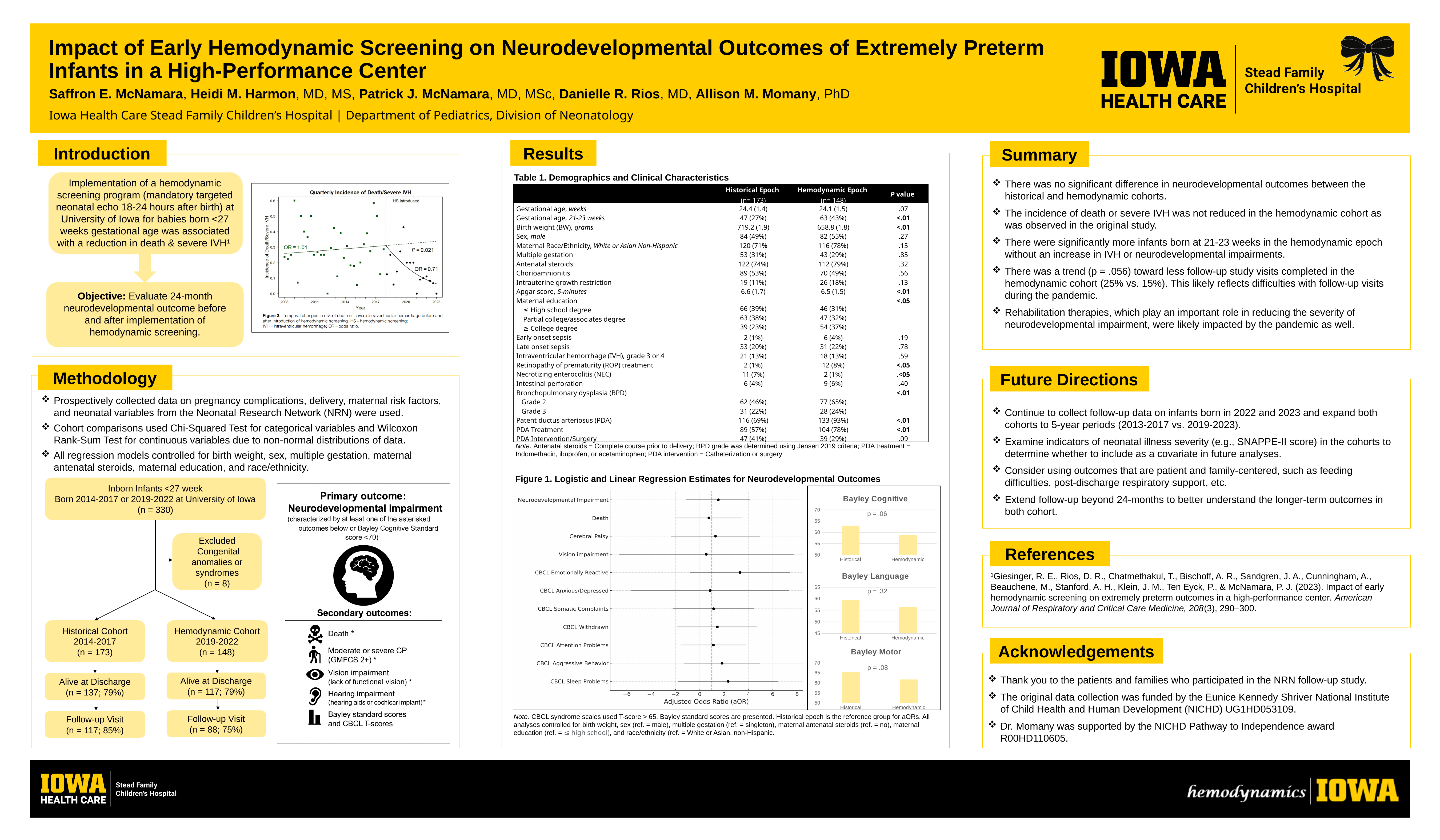
What kind of chart is the Bayley Cognitive chart? bar chart What p value is printed on the Bayley Cognitive chart? p = .06 In the Bayley Motor chart, is the value for Hemodynamic greater or less than 55? greater How many outcome categories are listed on the y axis of the forest plot in Figure 1? 11 How many bars does the Bayley Language chart show? 2 In the Bayley Language chart, is the value for Historical greater or less than 55? greater In the Bayley Cognitive chart, which cohort has the higher bar, Historical or Hemodynamic? Historical In the Bayley Language chart, which cohort has the higher bar, Historical or Hemodynamic? Historical In the forest plot of Figure 1, which outcome has the highest adjusted odds ratio point estimate? CBCL Emotionally Reactive In the Bayley Cognitive chart, is the value for Historical greater or less than 60? greater In Figure 3 (Quarterly Incidence of Death/Severe IVH), does the fitted line after HS Introduced rise or fall over time? fall In the Bayley Motor chart, which cohort has the higher bar, Historical or Hemodynamic? Historical